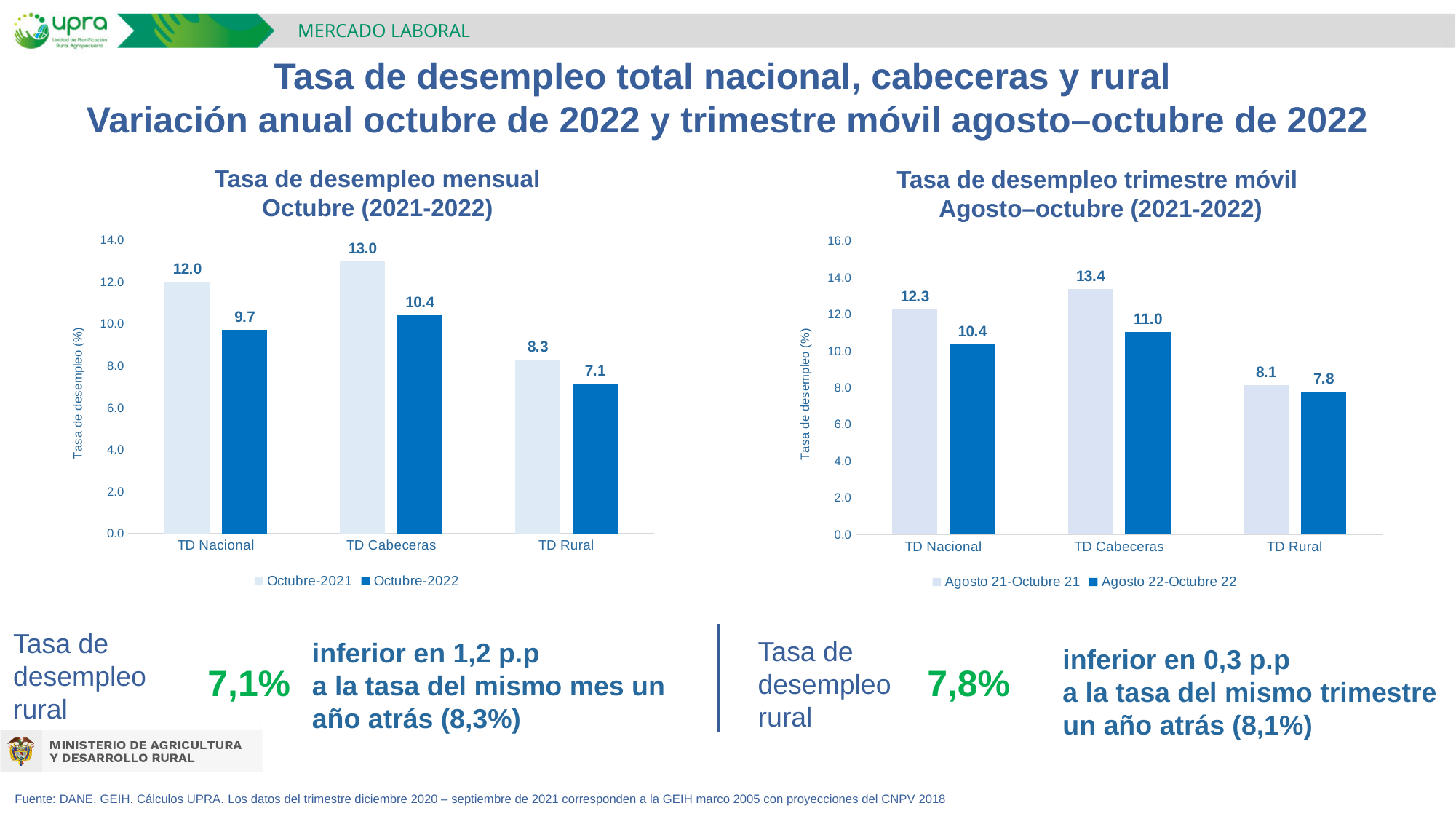
In the 'Tasa de desempleo mensual Octubre (2021-2022)' chart, what is the value for TD Cabeceras in Octubre-2022? 10.4 In the 'Tasa de desempleo trimestre móvil Agosto–octubre (2021-2022)' chart, what is the difference between the Agosto 21-Octubre 21 and Agosto 22-Octubre 22 values for TD Rural? 0.3 In the 'Tasa de desempleo trimestre móvil Agosto–octubre (2021-2022)' chart, which category has the lowest Agosto 22-Octubre 22 value? TD Rural In the 'Tasa de desempleo mensual Octubre (2021-2022)' chart, which category has the highest Octubre-2021 value? TD Cabeceras In the 'Tasa de desempleo mensual Octubre (2021-2022)' chart, what is the value for TD Rural in Octubre-2021? 8.3 In the 'Tasa de desempleo trimestre móvil Agosto–octubre (2021-2022)' chart, what is the value for TD Nacional in Agosto 22-Octubre 22? 10.4 What type of chart is the 'Tasa de desempleo mensual Octubre (2021-2022)' chart? Bar chart In the 'Tasa de desempleo mensual Octubre (2021-2022)' chart, what is the difference between the Octubre-2021 and Octubre-2022 values for TD Nacional? 2.3 In the 'Tasa de desempleo trimestre móvil Agosto–octubre (2021-2022)' chart, which is larger: TD Cabeceras in Agosto 22-Octubre 22 or TD Nacional in Agosto 21-Octubre 21? TD Nacional in Agosto 21-Octubre 21 In the 'Tasa de desempleo mensual Octubre (2021-2022)' chart, how many series does the legend list? 2 How many categories are shown on the x axis of the 'Tasa de desempleo trimestre móvil Agosto–octubre (2021-2022)' chart? 3 In the 'Tasa de desempleo trimestre móvil Agosto–octubre (2021-2022)' chart, what is the value for TD Cabeceras in Agosto 21-Octubre 21? 13.4